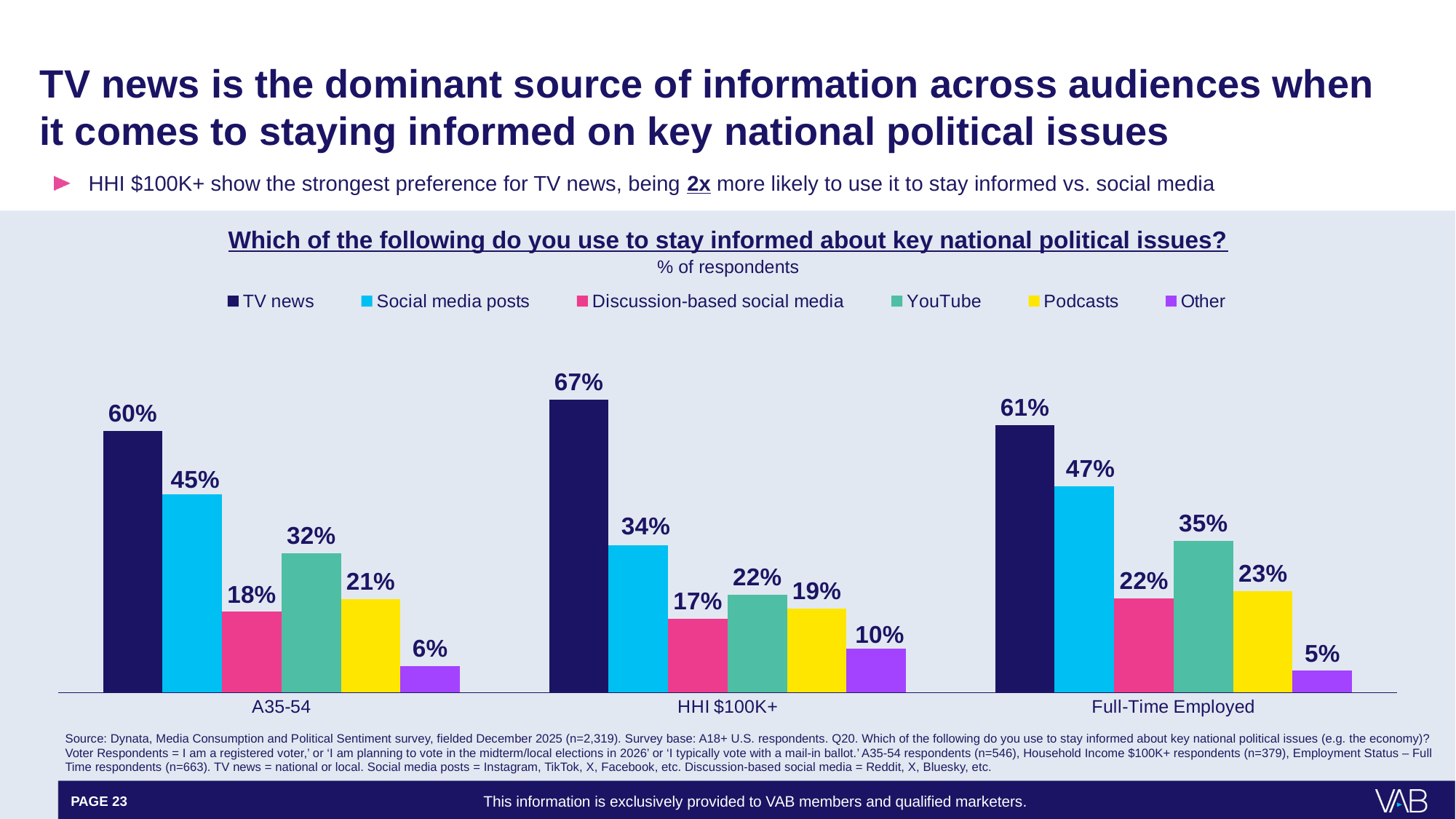
How many series does the legend list? 6 What is the total of the YouTube values across the three audience groups? 89% How many audience groups are shown on the x axis? 3 Which is larger for A35-54 respondents: YouTube or Podcasts? YouTube What is the difference between TV news and Social media posts for HHI $100K+ respondents? 33 percentage points What percentage of Full-Time Employed respondents use Podcasts? 23% Which source has the lowest value among Full-Time Employed respondents? Other Which colour represents Podcasts in the legend? Yellow What kind of chart is shown on the slide? Bar chart What is the value for Social media posts among HHI $100K+ respondents? 34% Which audience group has the highest value for TV news? HHI $100K+ What percentage of A35-54 respondents use TV news to stay informed about key national political issues? 60%